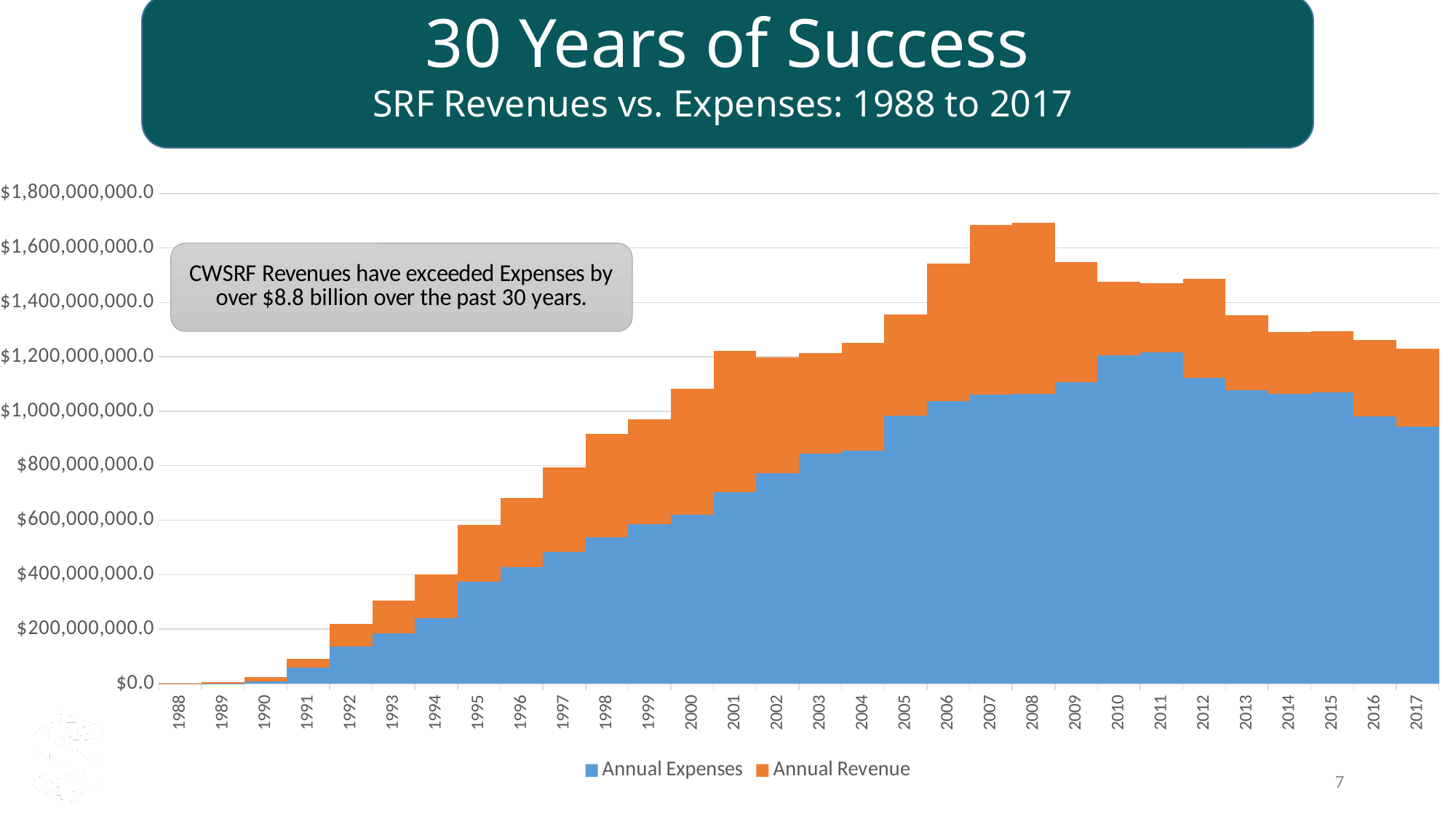
Do the Annual Expenses values generally rise or fall from 1988 to 2010? rise Which series is shown in orange in the chart? Annual Revenue Is the combined stacked total (Annual Expenses plus Annual Revenue) for 2007 greater or less than $1,600,000,000.0? greater Is the Annual Expenses value for 2017 greater or less than $1,000,000,000.0? less According to the text box on the chart, by how much have CWSRF Revenues exceeded Expenses over the past 30 years? over $8.8 billion How many series does the chart legend list? 2 Do the combined stacked totals rise or fall from 2008 to 2017? fall Is the combined stacked total for 2016 greater or less than $1,200,000,000.0? greater How many years are shown on the x axis of the chart? 30